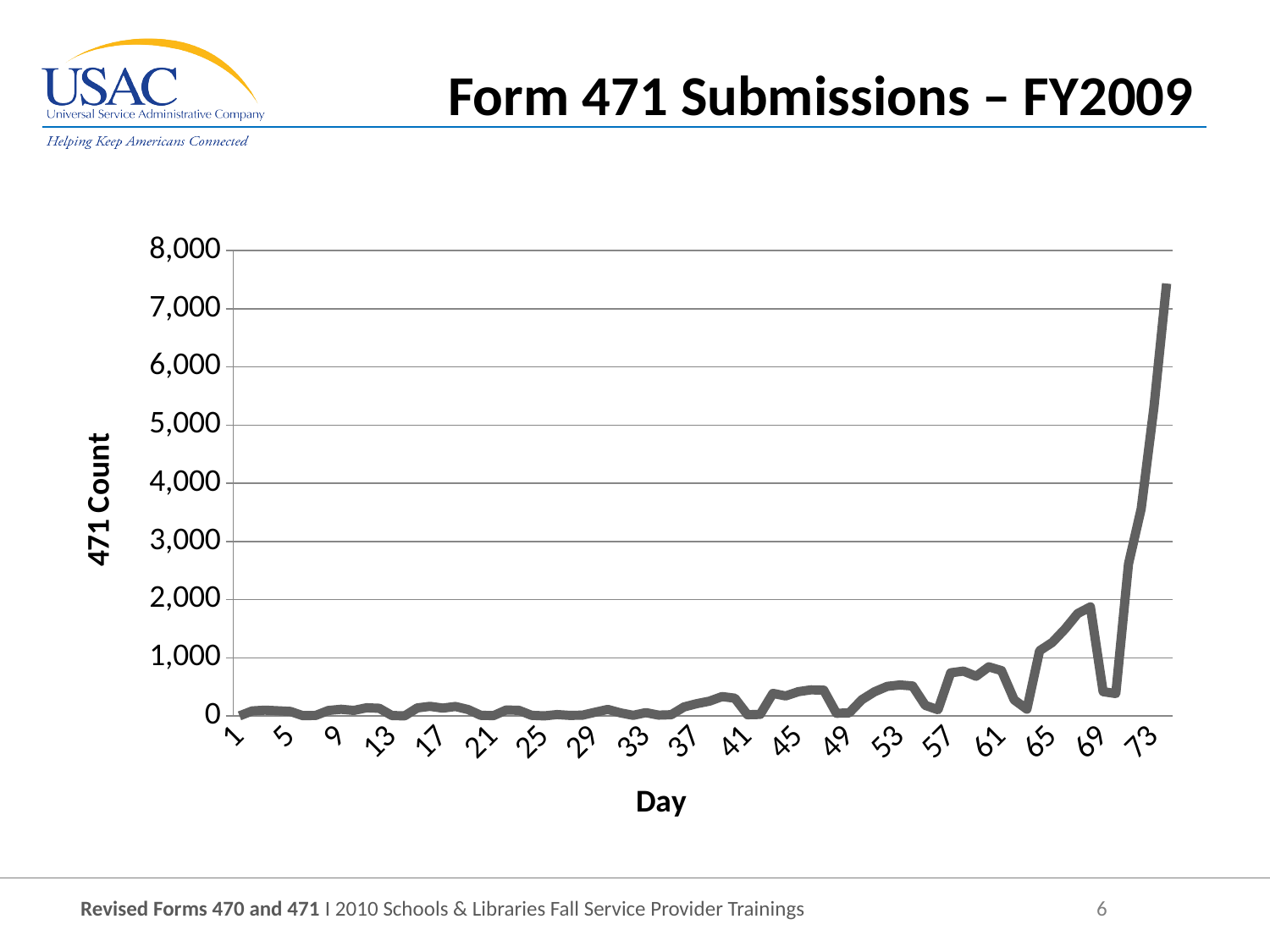
What kind of chart is shown on the slide? line chart Which has the larger value, day 69 or day 71? day 71 What is the title of the chart? Form 471 Submissions – FY2009 Is the value for day 1 greater or less than 1,000? less Is the value for day 57 greater or less than 1,000? less Is the value for day 73 greater or less than 3,000? greater Overall, do the values rise or fall as the day number increases along the x axis? rise Does the highest value on the chart occur at the beginning or at the end of the day range? at the end What is the label on the vertical axis of the chart? 471 Count Which has the larger value, day 1 or day 73? day 73